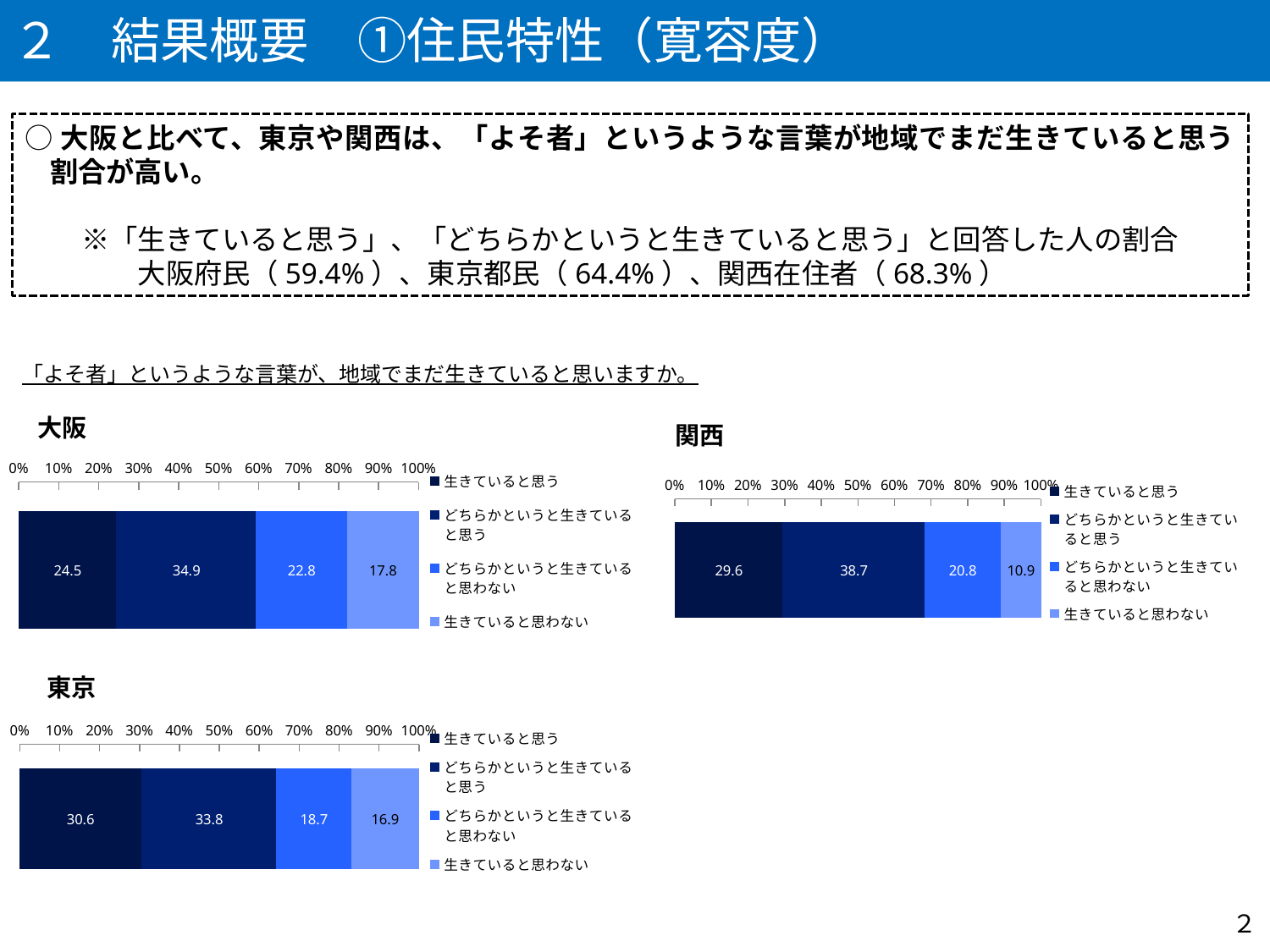
In the 東京 chart, what is the difference between 生きていると思う and 生きていると思わない? 13.7 Which is larger: 生きていると思う in the 東京 chart or 生きていると思う in the 大阪 chart? 東京 In the 大阪 chart, what is the combined value of 生きていると思う and どちらかというと生きていると思う? 59.4 In the 大阪 chart, which segment has the largest value? どちらかというと生きていると思う What kind of chart is the 関西 chart? Stacked bar chart In the 関西 chart, what is the value for どちらかというと生きていると思う? 38.7 In the 関西 chart, what is the value for 生きていると思わない? 10.9 In the 大阪 chart, what is the value for 生きていると思う? 24.5 In the 東京 chart, what is the value for 生きていると思わない? 16.9 How many series does the legend of the 大阪 chart list? 4 In the 関西 chart, which segment has the smallest value? 生きていると思わない How many charts are shown on the slide? 3